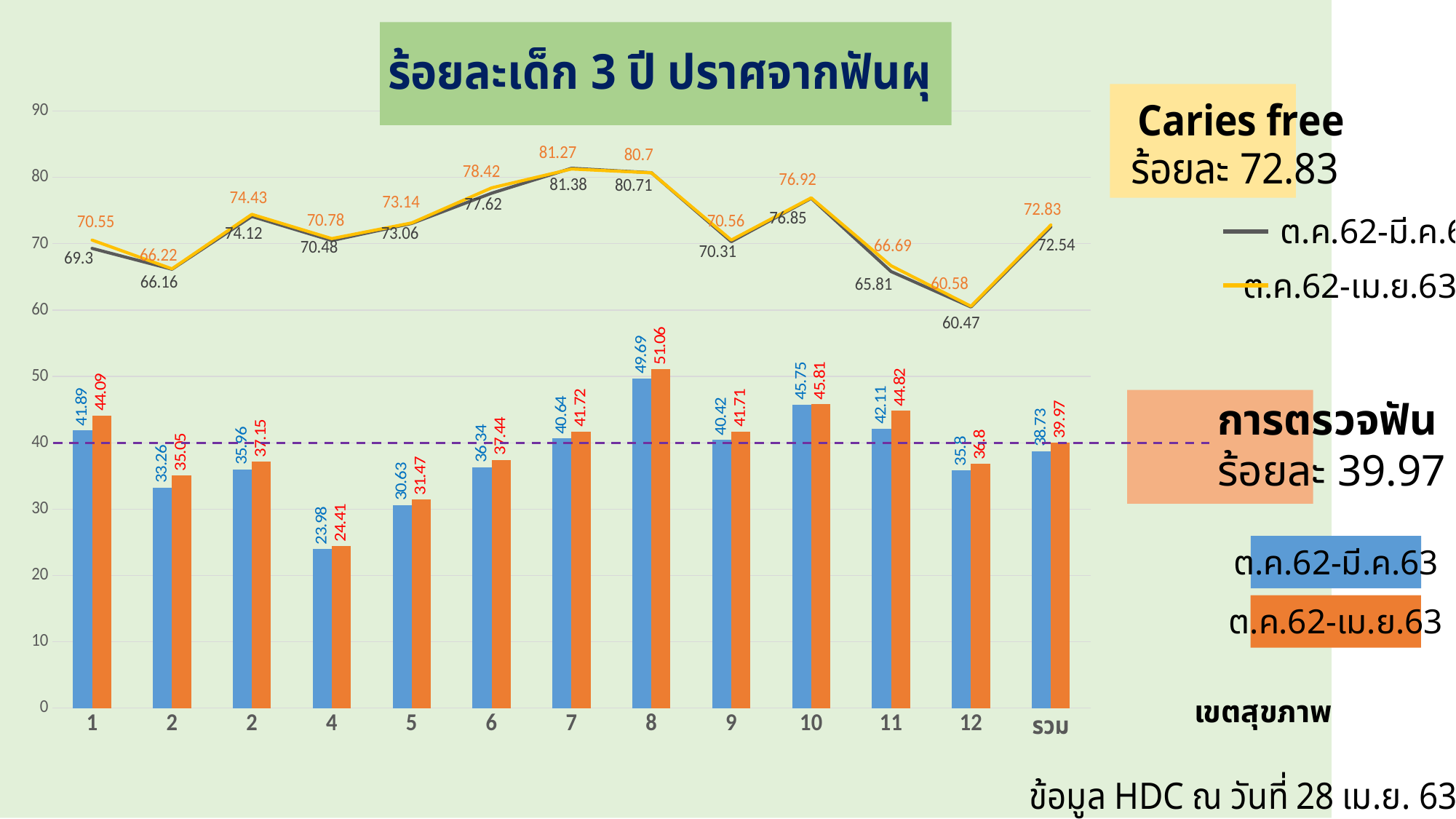
Is the blue bar for region 4 greater or less than 30? less How many series are listed in the legends on the slide? 4 Which region has the lowest value on the yellow line (ต.ค.62-เม.ย.63)? 12 Which region has the highest orange bar (ต.ค.62-เม.ย.63)? 8 What is the value of the orange bar (ต.ค.62-เม.ย.63) for region 8? 51.06 What is the value of the yellow line (ต.ค.62-เม.ย.63) for the รวม category? 72.83 Which region has the lowest blue bar (ต.ค.62-มี.ค.63)? 4 What kind of chart is shown on the slide? Combined bar and line chart What is the value of the yellow line (ต.ค.62-เม.ย.63) for region 7? 81.27 What is the difference between the orange bar and the blue bar for region 1? 2.2 How many categories are shown on the x axis? 13 Which is larger: the orange bar for region 10 or the orange bar for region 11? Region 10